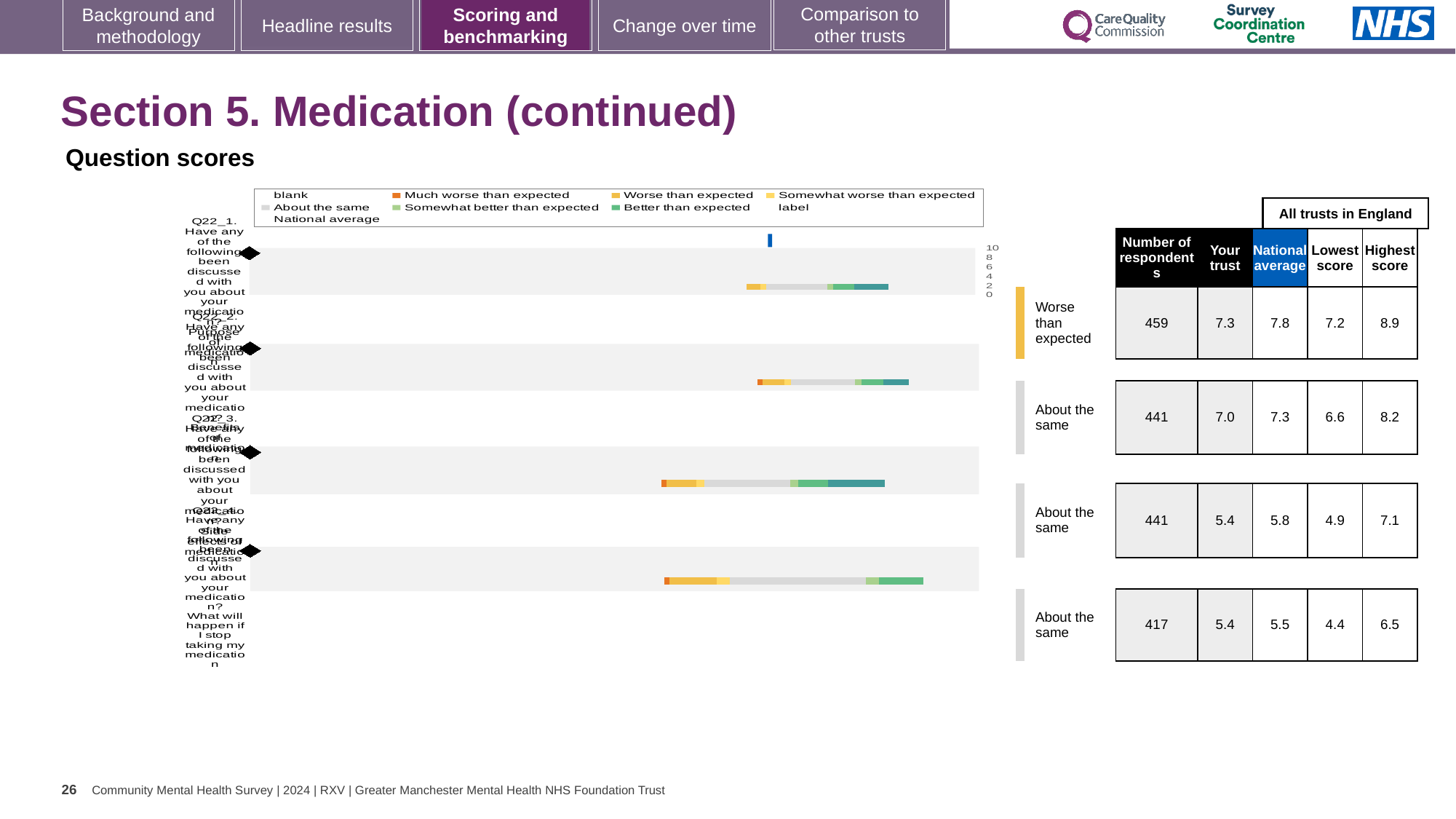
What is the 'Your trust' score in the first row of the table (459 respondents)? 7.3 Is the 'Your trust' score in the third row of the table (5.4) larger or smaller than the national average (5.8)? smaller Which row of the table has the fewest respondents? the last row (417) How many question bars are plotted in the chart? 4 What is the lowest score in the last row of the table (417 respondents)? 4.4 What is the national average in the first row of the table (459 respondents)? 7.8 How many of the four questions are rated 'About the same'? 3 In the chart legend, which colour represents 'Much worse than expected'? orange Which benchmark category is shown for the first question bar? Worse than expected What kind of chart is shown under 'Question scores'? bar chart What is the highest score in the second row of the table (441 respondents, 'Your trust' 7.0)? 8.2 What is the difference between the national average and 'Your trust' score in the first row of the table (459 respondents)? 0.5